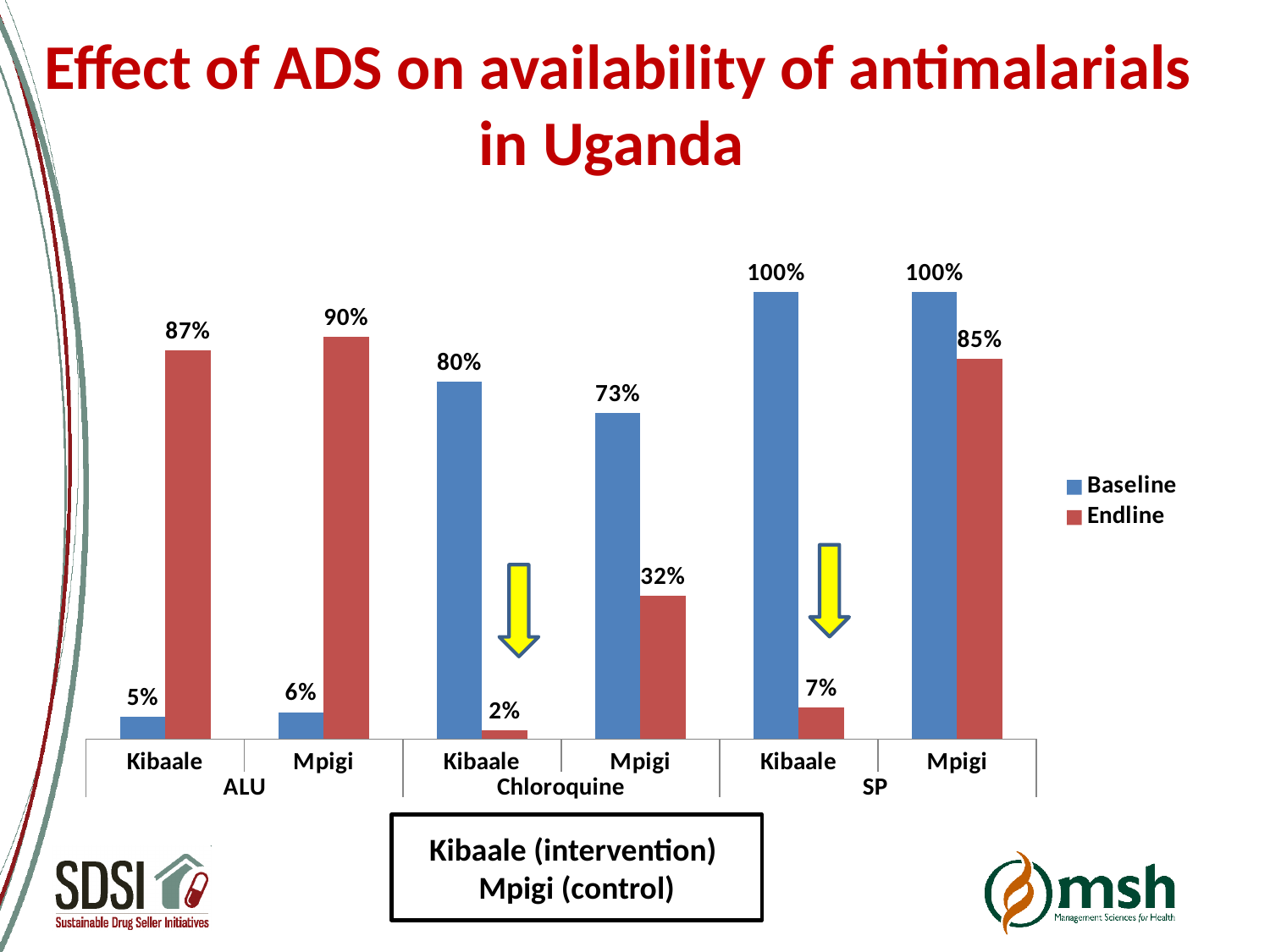
What is the Baseline value for Kibaale under ALU? 5% How many series does the legend list? 2 What is the Endline value for Kibaale under SP? 7% Which series is shown in blue in the legend? Baseline What is the Endline value for Kibaale under ALU? 87% Which category has the lowest Endline value? Kibaale (Chloroquine) What kind of chart is shown on the slide? Bar chart What is the Baseline value for Mpigi under Chloroquine? 73% Which is larger, the Endline value for Mpigi under Chloroquine or the Endline value for Mpigi under SP? Mpigi under SP What is the difference between the Baseline and Endline values for Kibaale under Chloroquine? 78% What is the difference between the Endline values for Mpigi and Kibaale under ALU? 3% How many district categories are plotted along the x axis? 6